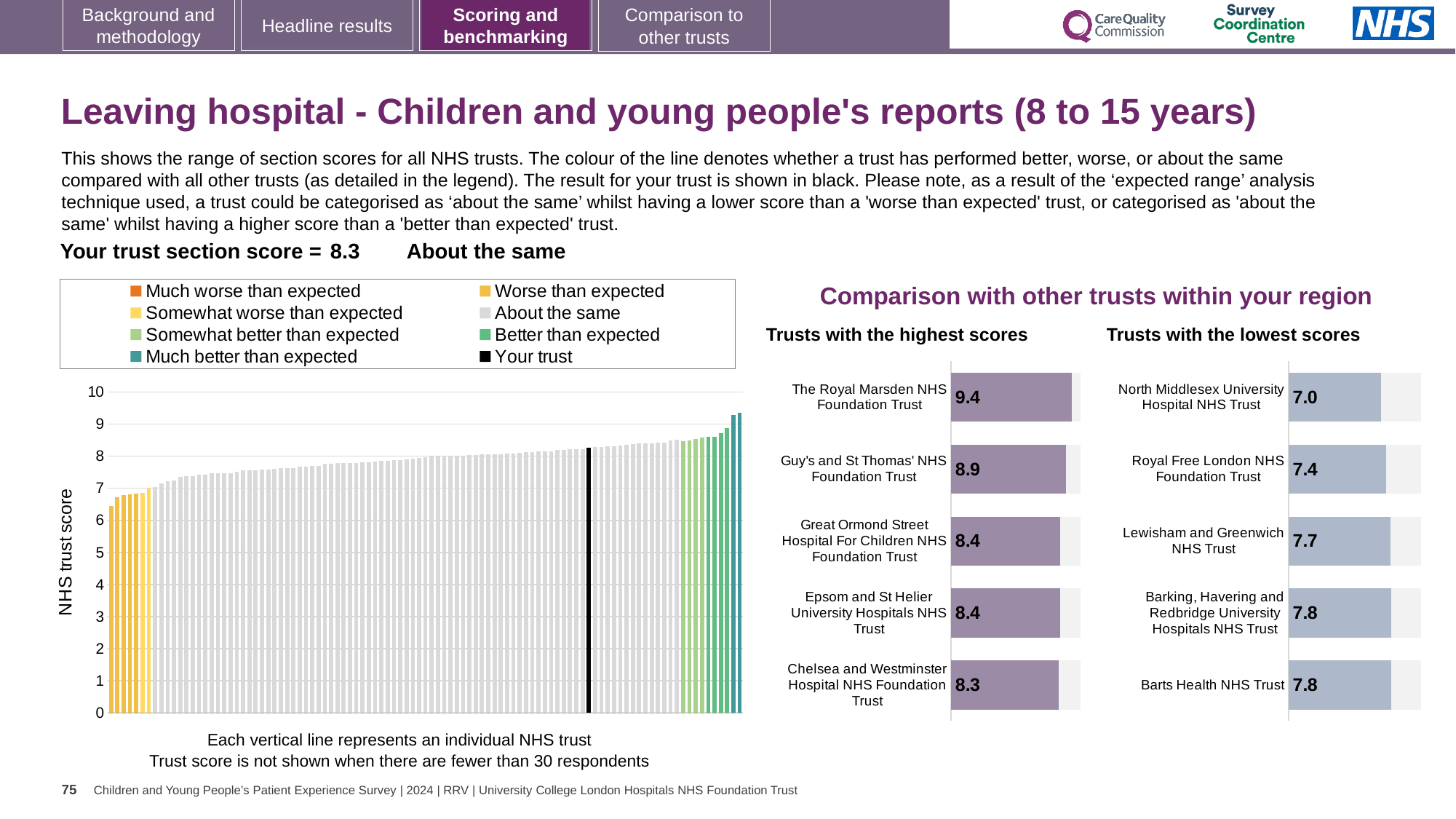
In the 'Trusts with the highest scores' chart, what is the difference between the scores of The Royal Marsden NHS Foundation Trust and Guy's and St Thomas' NHS Foundation Trust? 0.5 In the large chart on the left showing NHS trust scores, what kind of chart is it? Bar chart In the 'Trusts with the lowest scores' chart, which trust has the lowest score? North Middlesex University Hospital NHS Trust In the large chart on the left showing NHS trust scores, do the values rise or fall from left to right? Rise In the large chart on the left showing NHS trust scores, is the value for the black 'Your trust' bar greater or less than 8? greater In the large chart on the left showing NHS trust scores, how many entries does the legend list? 8 In the 'Trusts with the lowest scores' chart, which has the higher score: Royal Free London NHS Foundation Trust or Lewisham and Greenwich NHS Trust? Lewisham and Greenwich NHS Trust In the 'Trusts with the lowest scores' chart, what is the difference between the scores of Barts Health NHS Trust and North Middlesex University Hospital NHS Trust? 0.8 In the 'Trusts with the highest scores' chart, how many trusts are listed? 5 In the 'Trusts with the lowest scores' chart, what is the score for Lewisham and Greenwich NHS Trust? 7.7 In the 'Trusts with the highest scores' chart, which trust has the lowest score shown? Chelsea and Westminster Hospital NHS Foundation Trust In the 'Trusts with the highest scores' chart, what is the score for The Royal Marsden NHS Foundation Trust? 9.4